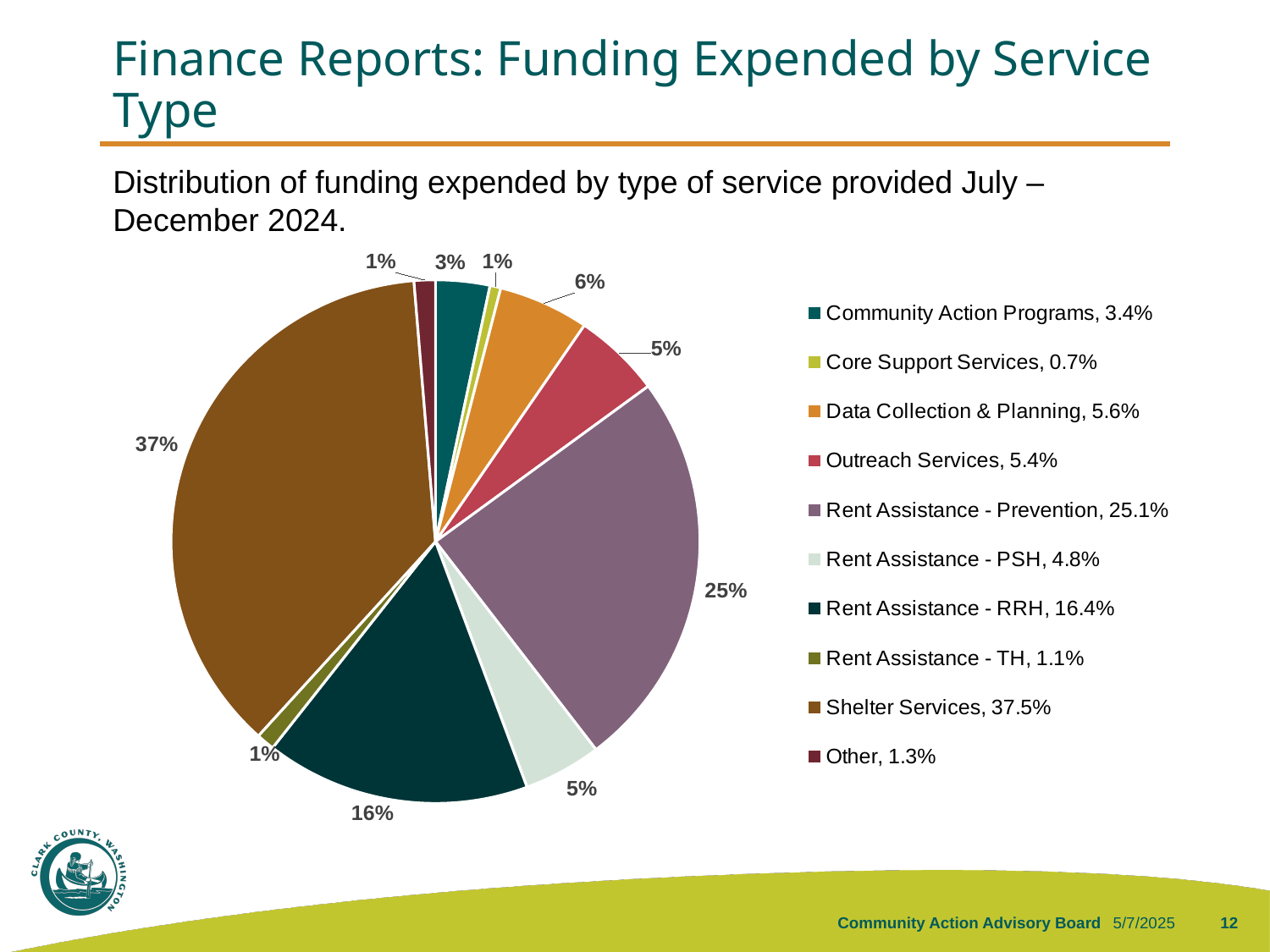
What percentage is shown for Rent Assistance - Prevention in the legend? 25.1% How many service type categories does the legend list? 10 Which service type received the smallest share of funding expended? Core Support Services Which service type received the largest share of funding expended? Shelter Services How many percentage points larger is the Shelter Services share than the Rent Assistance - Prevention share? 24.4 percentage points Which has a larger share: Data Collection & Planning or Outreach Services? Data Collection & Planning What time period does the chart's description say the funding distribution covers? July – December 2024 What percentage is listed for Community Action Programs? 3.4% What share of funding expended went to Shelter Services? 37.5% What kind of chart is shown on the slide? Pie chart What is the share of the pie for Rent Assistance - PSH? 4.8% What percentage of funding was expended on Rent Assistance - RRH? 16.4%